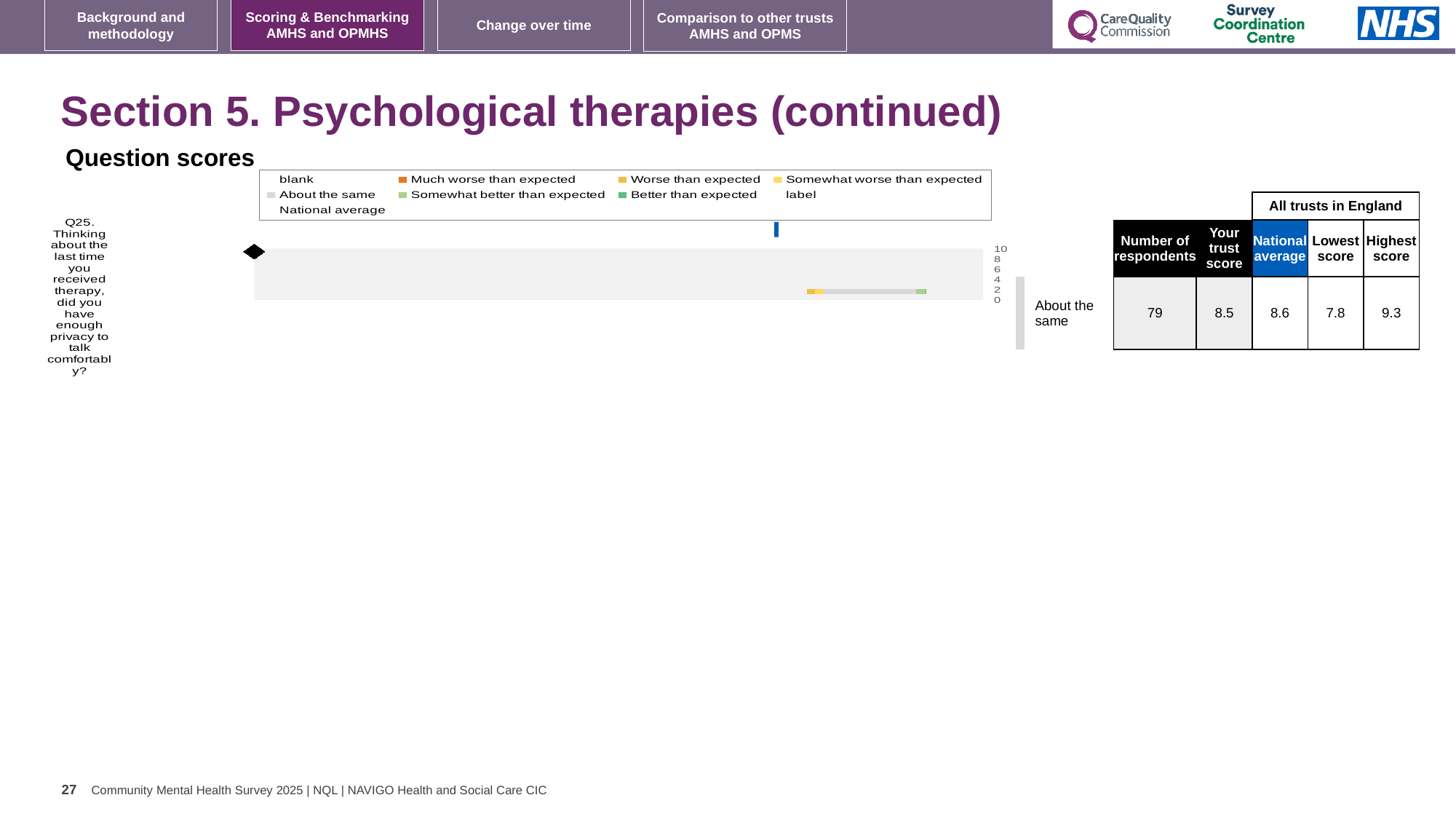
What kind of chart is used to show the Q25 question score? bar chart What is the difference between the highest and lowest trust scores for Q25? 1.5 What is the lowest score among all trusts in England for Q25? 7.8 Which is larger for Q25, the trust's score or the national average? national average What is the national average score for Q25? 8.6 Which question is plotted in the Question scores chart? Q25. Thinking about the last time you received therapy, did you have enough privacy to talk comfortably? What is the highest score among all trusts in England for Q25? 9.3 Which benchmark category is the trust's Q25 score placed in? About the same How many survey questions are plotted in the Question scores chart? 1 What is the trust's score for Q25? 8.5 How many respondents answered Q25? 79 In the chart legend, which category is shown in orange? Much worse than expected